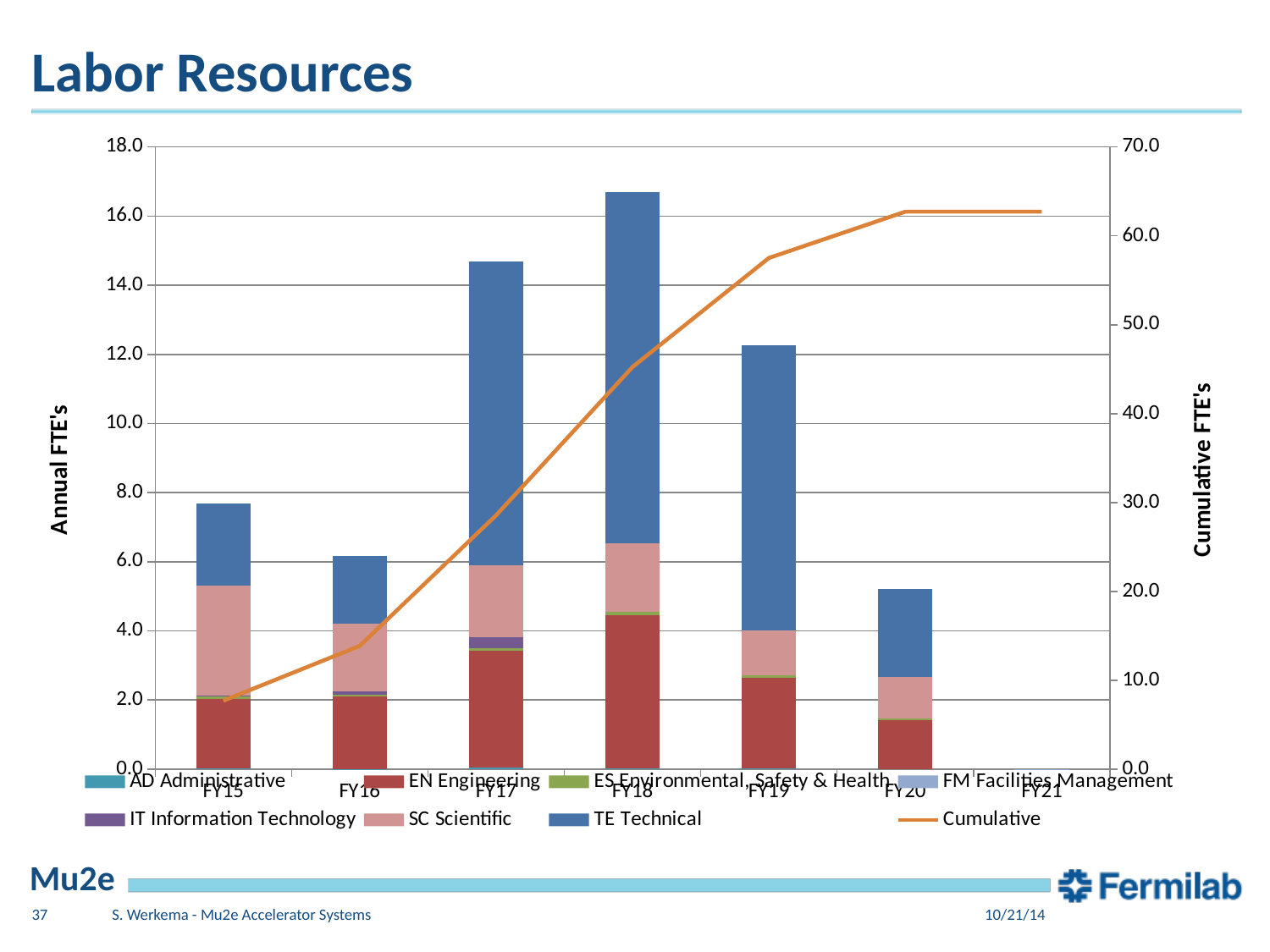
Is the total stacked bar for FY15 greater or less than 8.0 Annual FTE's? less What kind of chart is shown on the slide? Stacked bar chart with a line Is the Cumulative value at FY21 greater or less than 60.0 on the right axis? greater How many series does the legend list? 8 Among the fiscal years with a bar, which has the shortest stacked bar? FY20 How many fiscal years are shown on the x axis? 7 Is the total stacked bar for FY18 greater or less than 16.0 Annual FTE's? greater Which has the larger total stacked bar, FY16 or FY17? FY17 What is the title of the left vertical axis? Annual FTE's Which fiscal year has the tallest stacked bar? FY18 Does the Cumulative line rise or fall from FY15 to FY20? rise